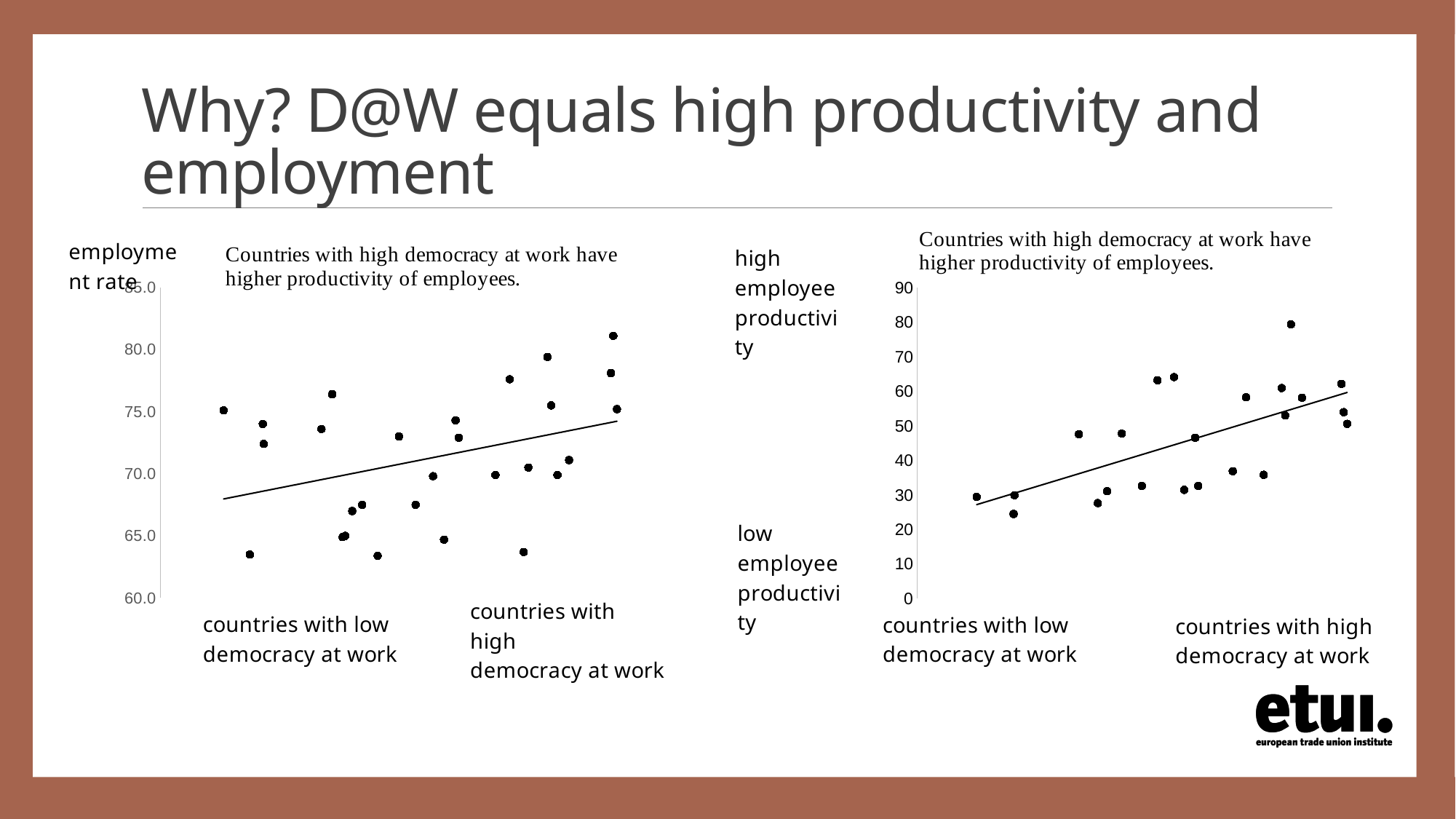
On the left chart (employment rate), is the highest plotted point greater or less than 80.0? greater On the right chart (employee productivity), is the highest plotted point greater or less than 70? greater On the left chart (employment rate), does the trend line rise or fall from countries with low democracy at work to countries with high democracy at work? rise On the left chart (employment rate), is the lowest plotted point greater or less than 65.0? less On the left chart, what is the label of the vertical axis? employment rate On the right chart (employee productivity), what is the maximum value shown on the vertical axis? 90 What kind of chart is the left chart (employment rate)? scatter chart On the right chart (employee productivity), does the trend line rise or fall from countries with low democracy at work to countries with high democracy at work? rise What kind of chart is the right chart (employee productivity)? scatter chart